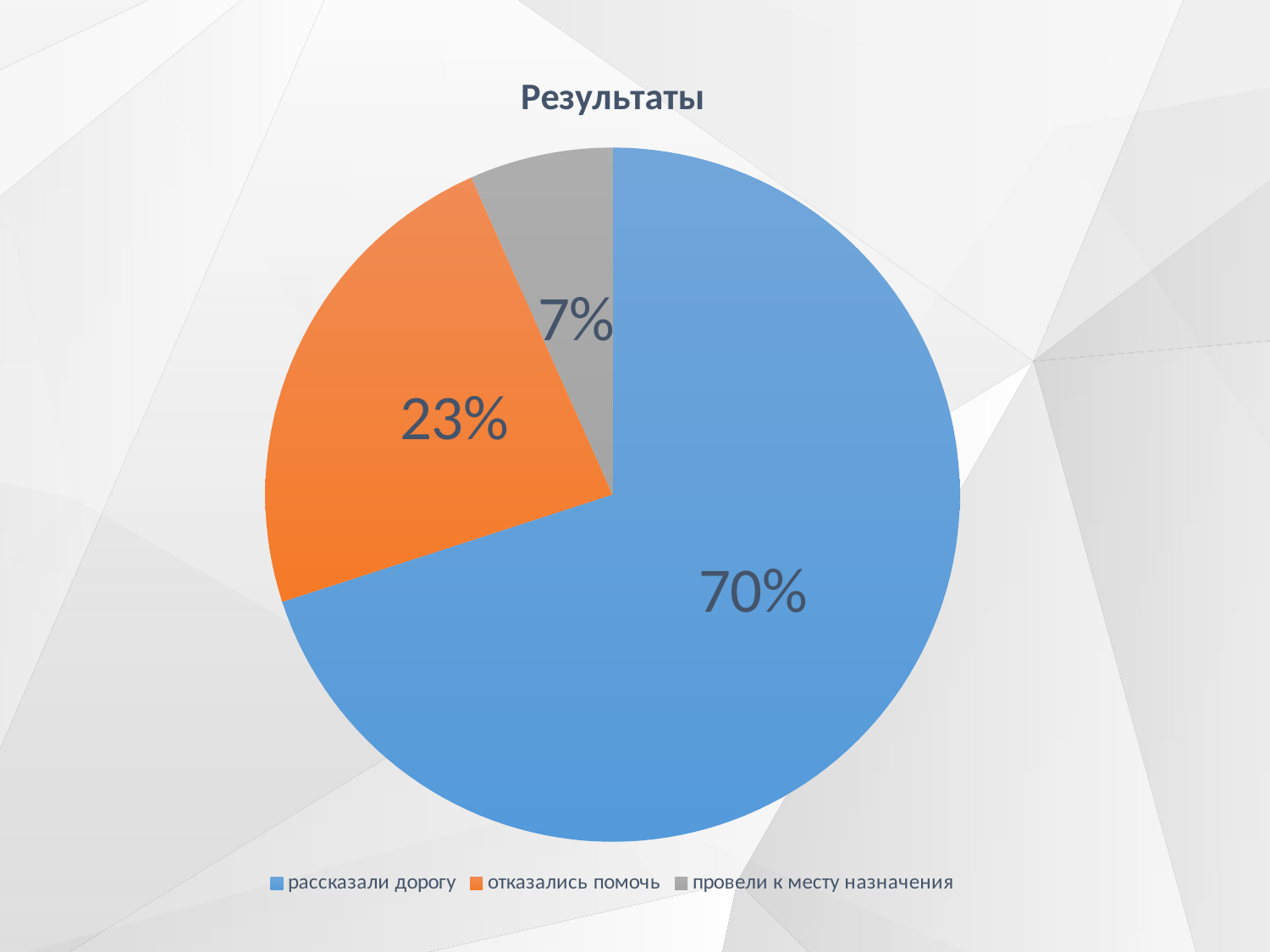
What share of the pie is labelled "рассказали дорогу"? 70% How many categories does the pie chart have? 3 What type of chart is shown on the slide? pie chart What is the difference in percentage points between "отказались помочь" and "провели к месту назначения"? 16 Which category has the largest slice of the pie? рассказали дорогу Which is larger: the slice for "отказались помочь" or the slice for "провели к месту назначения"? отказались помочь What is the difference in percentage points between "рассказали дорогу" and "отказались помочь"? 47 What is the chart's title? Результаты What share of the pie is labelled "провели к месту назначения"? 7% What share of the pie is labelled "отказались помочь"? 23% What colour is the slice for "отказались помочь"? orange Which category has the smallest slice of the pie? провели к месту назначения